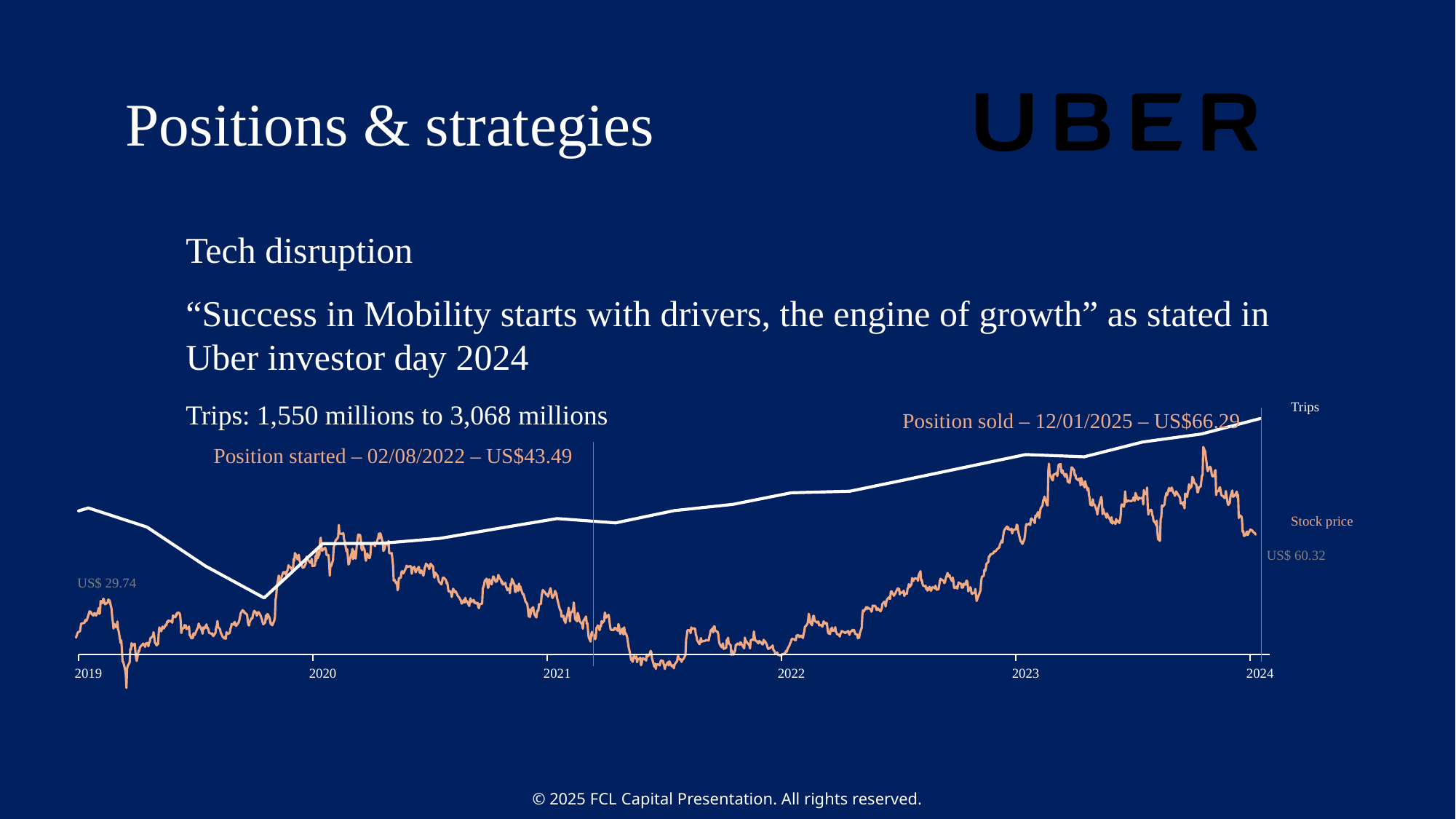
What stock price is labelled at the start of the chart in 2019? US$ 29.74 Does the Trips line rise or fall between 2020 and 2024? Rise What are the names of the two series plotted on the chart? Trips and Stock price At what price was the position started on 02/08/2022? US$43.49 Which is larger, the stock price labelled at the start of the chart or the stock price labelled at the end? The end (US$ 60.32) How many year labels are shown on the x axis? 6 What stock price is labelled at the end of the chart in 2024? US$ 60.32 What is the difference between the position sold price (US$66.29) and the position started price (US$43.49)? US$22.80 How many series are plotted on the chart? 2 At what price was the position sold on 12/01/2025? US$66.29 What kind of chart is shown on the slide? Line chart What is the difference between the stock price labelled at the end of the chart (US$ 60.32) and at the start (US$ 29.74)? US$ 30.58